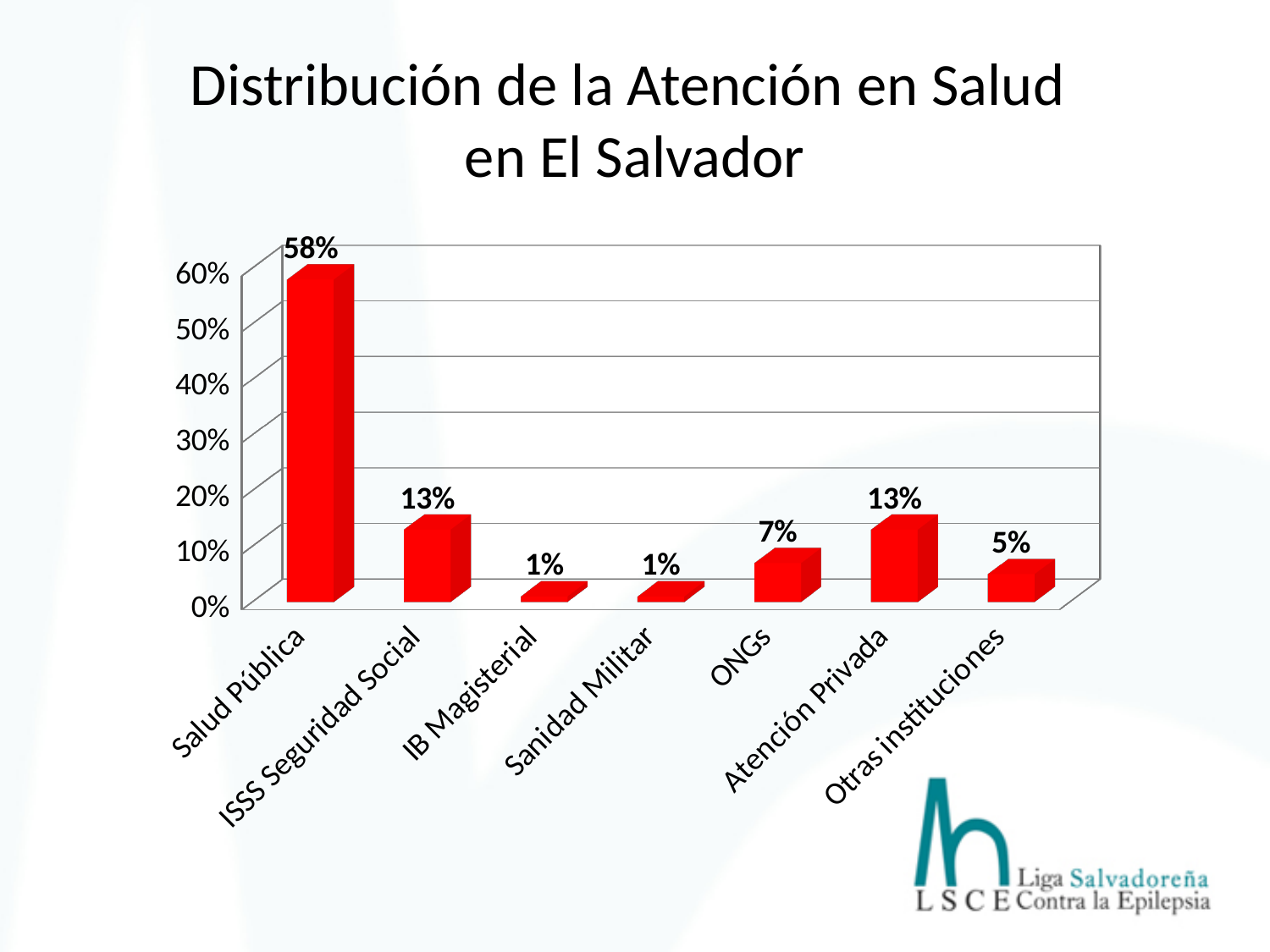
Which category has the highest value? Salud Pública What is the difference between the values for Salud Pública and Atención Privada? 45% What is the difference between the values for ONGs and Otras instituciones? 2% How many categories are shown on the x axis? 7 Which is larger, the value for ONGs or the value for Otras instituciones? ONGs What is the value for ONGs? 7% What is the title of the chart on the slide? Distribución de la Atención en Salud en El Salvador What is the value for Salud Pública? 58% What kind of chart is shown on the slide? Bar chart What is the value for Otras instituciones? 5% Is the value for Salud Pública greater or less than 50%? greater What is the value for ISSS Seguridad Social? 13%